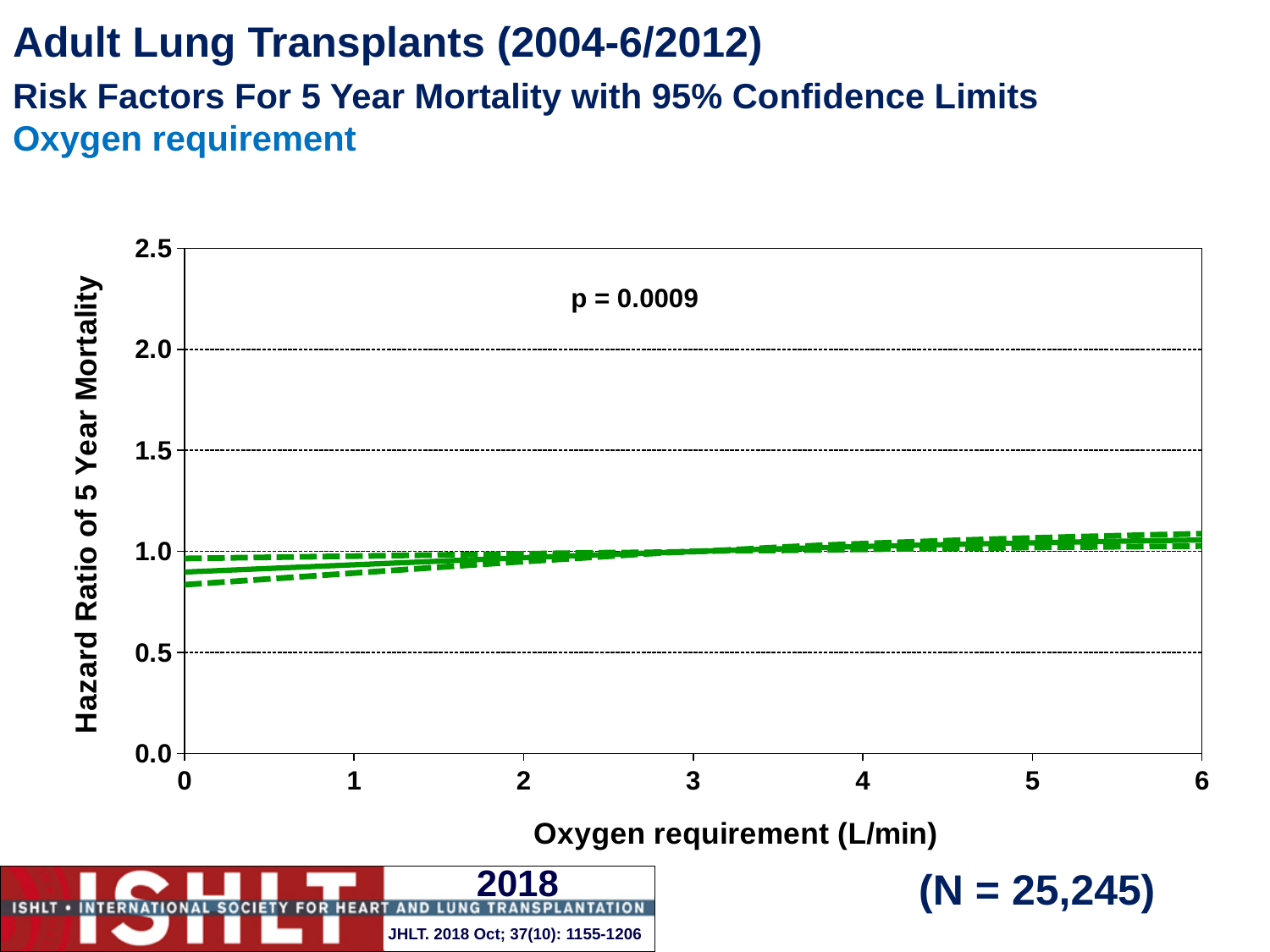
Is the hazard ratio of 5 year mortality at an oxygen requirement of 6 L/min greater or less than 2.0? less Does the hazard ratio of 5 year mortality rise or fall as oxygen requirement increases from 0 to 6 L/min? rise Is the hazard ratio of 5 year mortality at an oxygen requirement of 0 L/min greater or less than 1.0? less Is the hazard ratio of 5 year mortality at an oxygen requirement of 3 L/min greater or less than 1.5? less What is the highest oxygen requirement value shown on the x axis? 6 What p-value is printed on the chart? p = 0.0009 What is the sample size (N) shown on the slide? N = 25,245 What kind of chart is shown on the slide? line chart What is the highest value shown on the y axis of the chart? 2.5 How many lines (the estimate plus its confidence limits) are plotted on the chart? 3